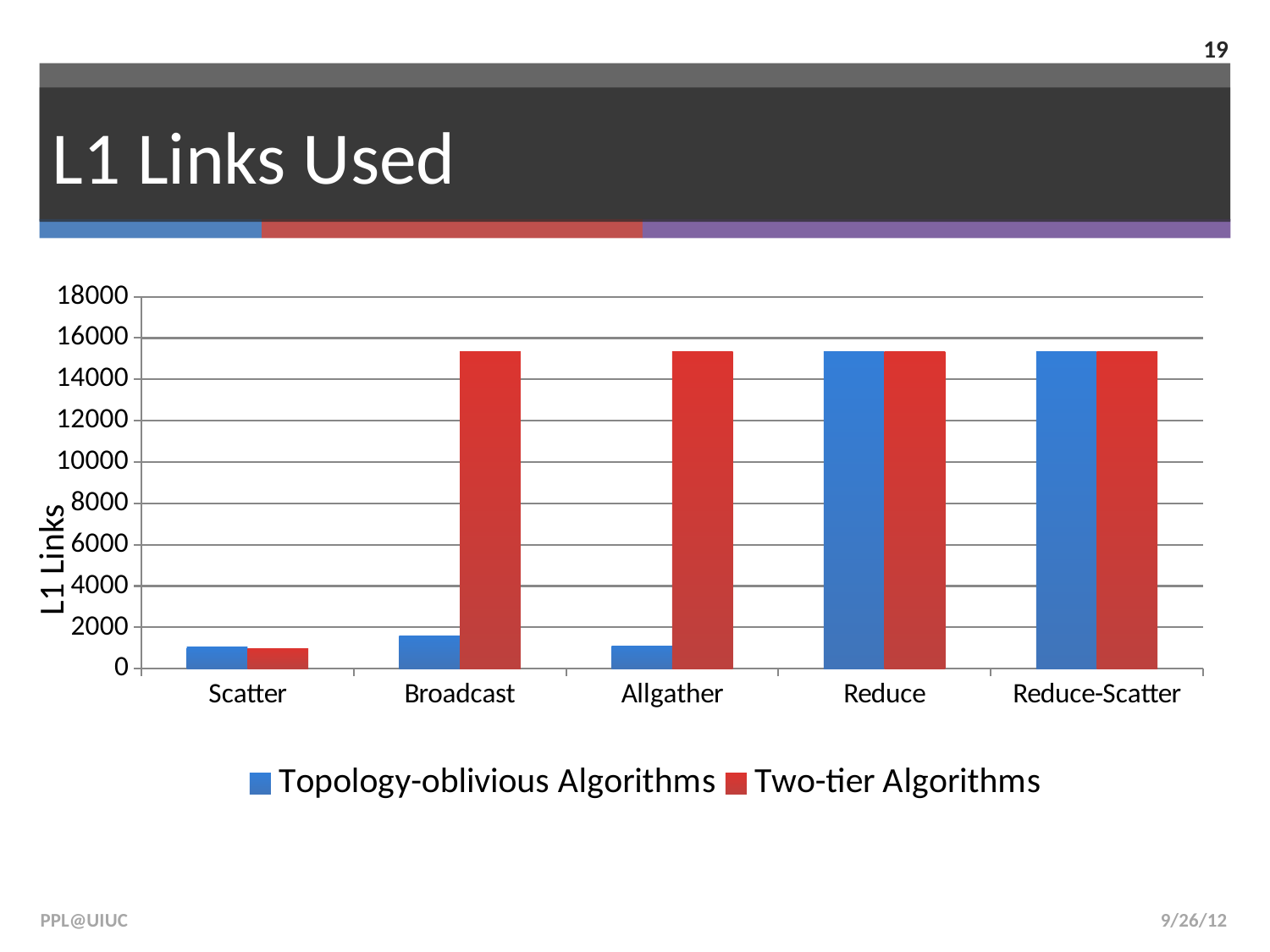
How many series does the legend list? 2 What is the label of the y axis? L1 Links How many categories are shown on the x axis? 5 Is the value for Two-tier Algorithms at Broadcast greater or less than 14000? greater Is the value for Two-tier Algorithms at Scatter greater or less than 2000? less What kind of chart is shown on the slide? bar chart Which series is shown in red in the legend? Two-tier Algorithms Is the value for Topology-oblivious Algorithms at Broadcast greater or less than 2000? less At Allgather, which series has the larger value, Topology-oblivious Algorithms or Two-tier Algorithms? Two-tier Algorithms At Broadcast, which series has the larger value, Topology-oblivious Algorithms or Two-tier Algorithms? Two-tier Algorithms Which category has the lowest value for Two-tier Algorithms? Scatter